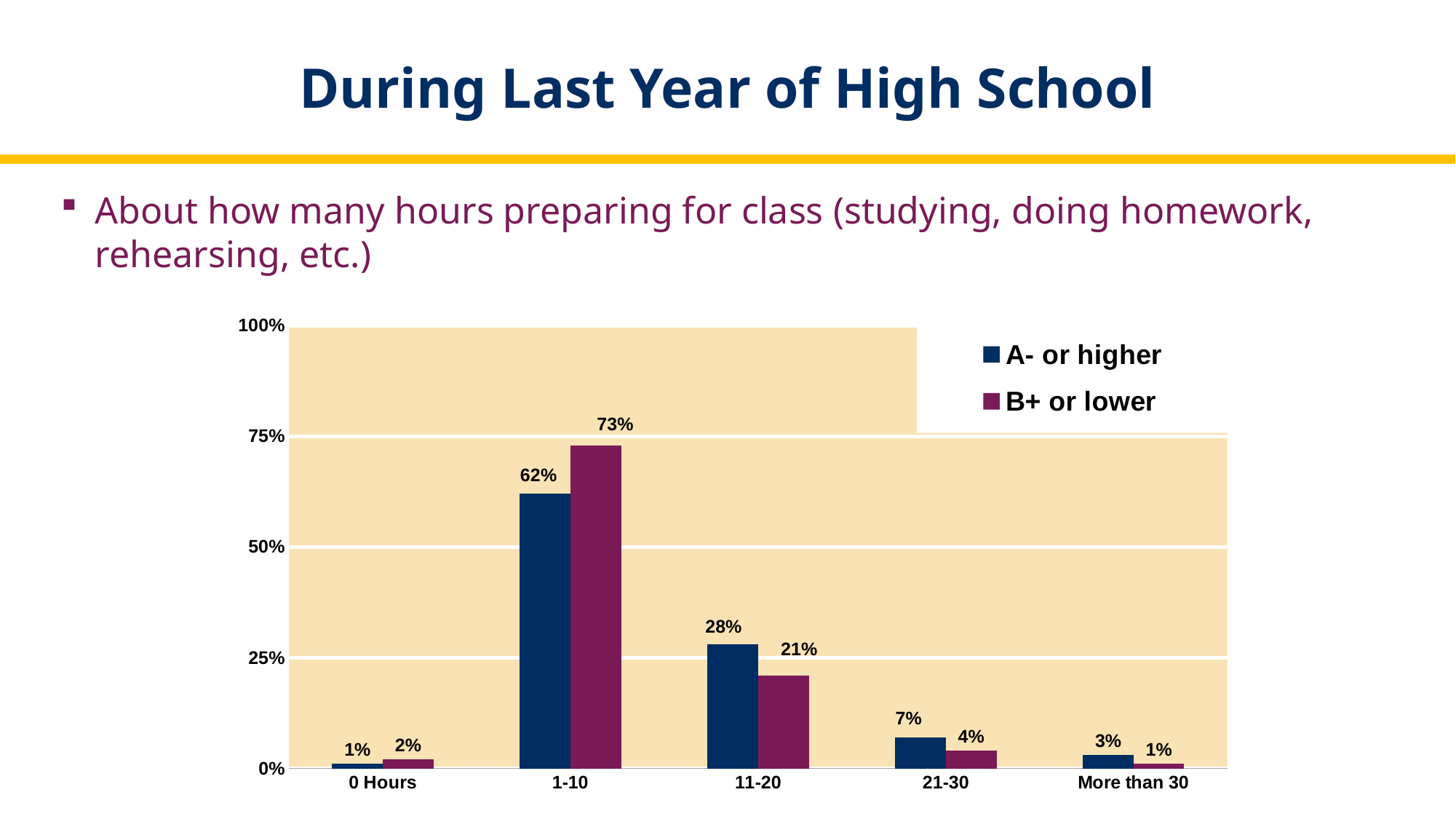
Is the "A- or higher" value for 11-20 hours greater or less than 25%? greater What is the difference between the "B+ or lower" and "A- or higher" values in the 1-10 hours category? 11% What percentage of the "B+ or lower" group spent 11-20 hours preparing for class? 21% What percentage of the "A- or higher" group spent 1-10 hours preparing for class? 62% In the 21-30 hours category, which series has the larger value? A- or higher What is the value for "B+ or lower" in the "More than 30" category? 1% How many series does the legend list? 2 Which hours category has the lowest value for the "A- or higher" series? 0 Hours What colour are the bars for the "B+ or lower" series? Purple Which hours category has the highest value for the "B+ or lower" series? 1-10 What kind of chart is shown on the slide? Bar chart How many hours categories are shown on the x axis? 5